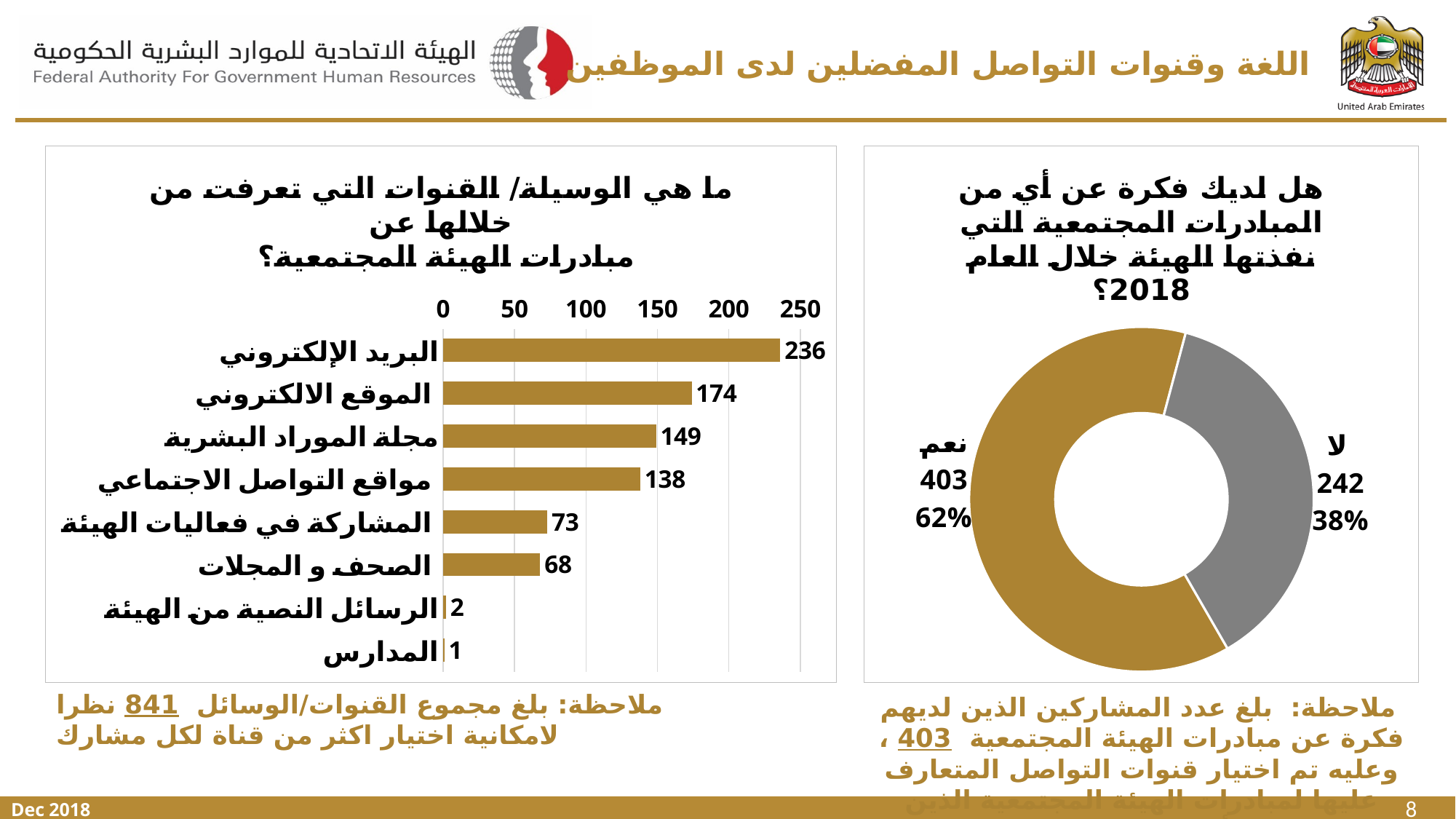
In the left bar chart, what is the value for مواقع التواصل الاجتماعي? 138 What type of chart is the chart on the left of the slide? Bar chart In the right donut chart, what is the count shown for لا? 242 In the left bar chart, how many categories are shown? 8 In the left bar chart, which is larger: المشاركة في فعاليات الهيئة or الصحف و المجلات? المشاركة في فعاليات الهيئة In the left bar chart, which category has the highest value? البريد الإلكتروني In the right donut chart, which segment is larger: نعم or لا? نعم In the left bar chart, what is the difference between the values for الموقع الالكتروني and مجلة الموراد البشرية? 25 What type of chart is the chart on the right of the slide? Donut chart In the right donut chart, what percentage is shown for نعم? 62% In the left bar chart, what is the value for البريد الإلكتروني? 236 In the left bar chart, which category has the lowest value? المدارس